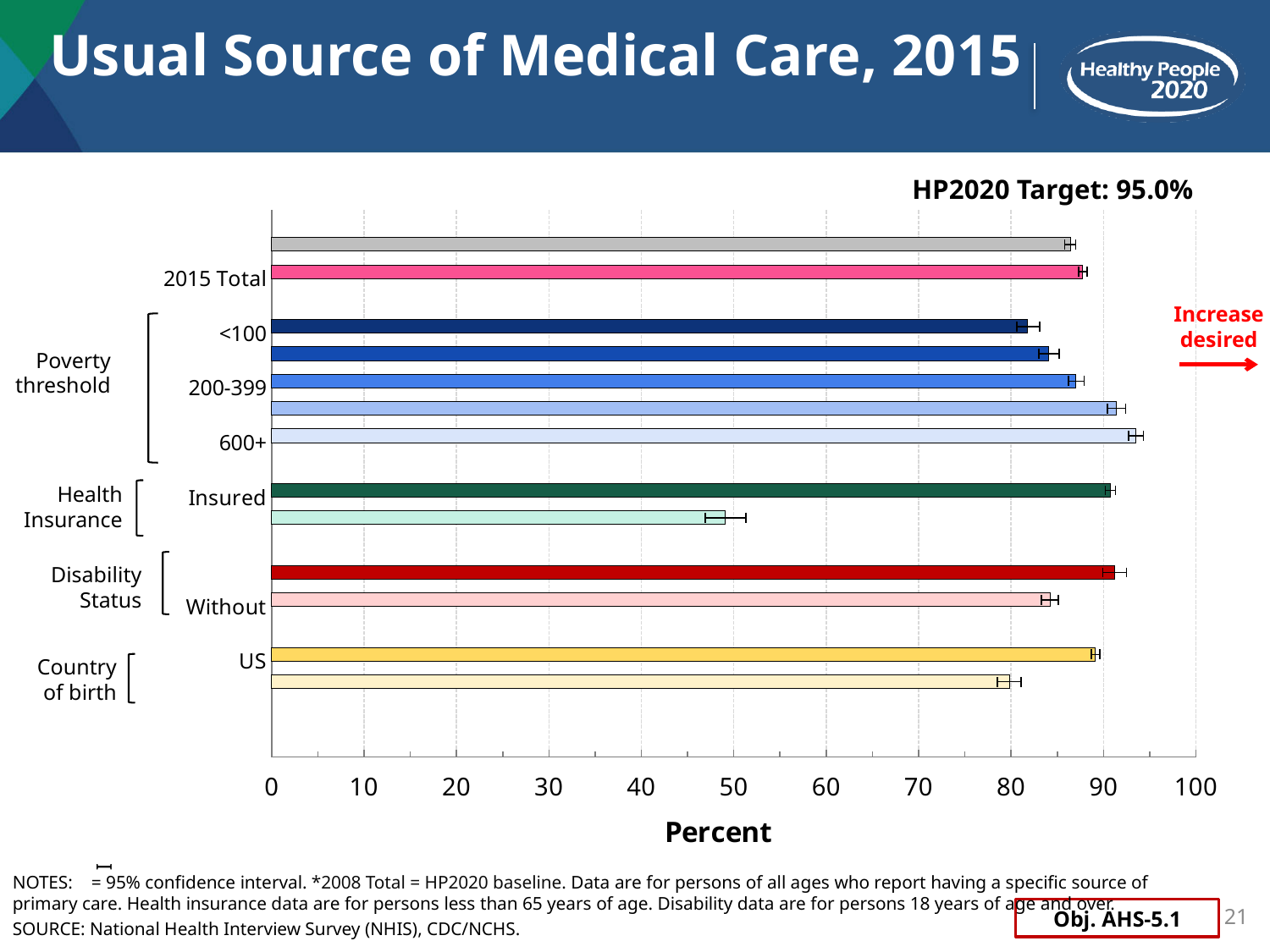
Is the value for the 600+ poverty threshold group greater or less than 90? greater Is the value for the Without disability group greater or less than 90? less Which has a higher value, the 600+ poverty threshold group or the <100 poverty threshold group? 600+ Which has a higher value, Insured or Without (disability)? Insured Is the value for the <100 poverty threshold group greater or less than 90? less Which has a higher value, US country of birth or the <100 poverty threshold group? US What type of chart is shown on the slide? bar chart What is the label of the x axis? Percent How many demographic groupings (bracketed categories) are shown on the y axis besides 2015 Total? 4 What is the HP2020 Target value shown on the slide? 95.0%